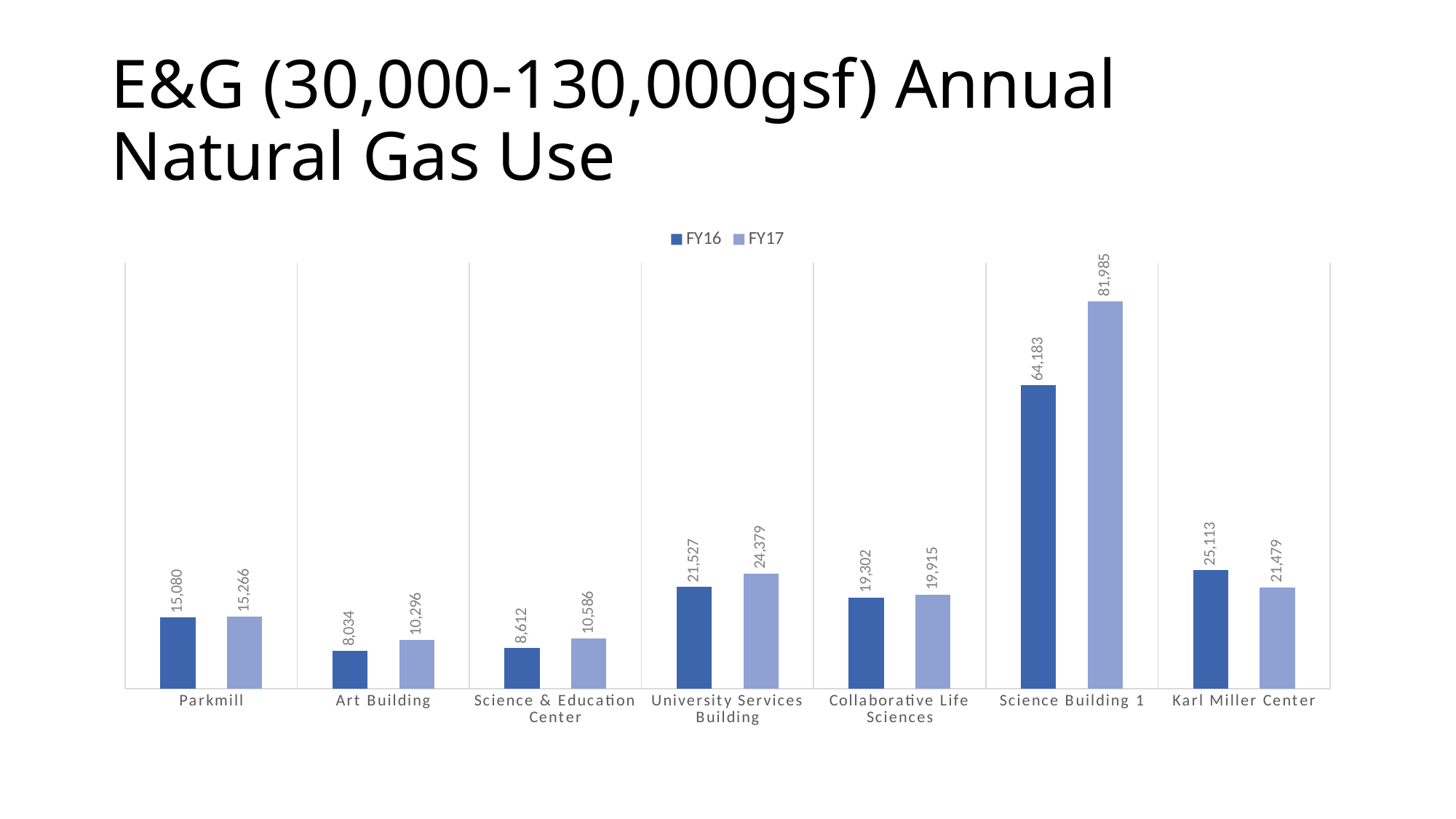
What kind of chart is shown on the slide? Bar chart Which building has the highest FY17 natural gas use? Science Building 1 Which is larger for University Services Building, the FY16 value or the FY17 value? FY17 What is the FY17 natural gas use for Science Building 1? 81,985 Which building has the lowest FY16 natural gas use? Art Building What is the difference between the FY17 and FY16 values for Science Building 1? 17,802 What is the FY17 value for the Art Building? 10,296 What is the difference between the FY16 and FY17 values for Karl Miller Center? 3,634 What is the FY16 value for Karl Miller Center? 25,113 How many series does the legend list? 2 What is the FY16 natural gas use for Parkmill? 15,080 How many buildings are shown on the x axis? 7